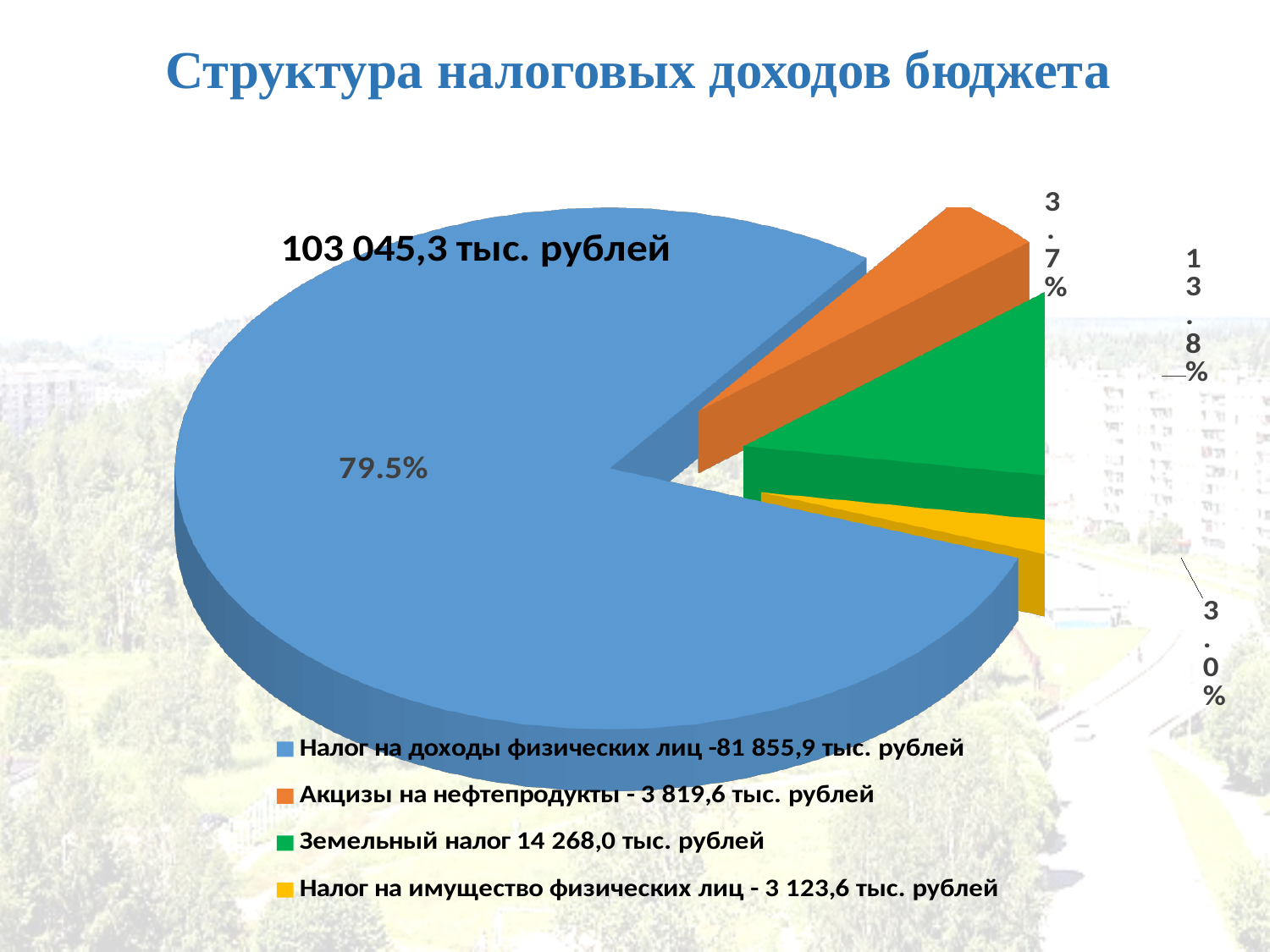
Which category has the largest slice of the pie? Налог на доходы физических лиц What share of the pie is labelled for Налог на доходы физических лиц? 79.5% What share of the pie is labelled for Земельный налог? 13.8% What share of the pie is labelled for Налог на имущество физических лиц? 3.0% Which category has the smallest slice of the pie? Налог на имущество физических лиц What is the difference in percentage points between the share for Налог на доходы физических лиц and the share for Земельный налог? 65.7 How many slices does the pie chart have? 4 Which is larger: the share for Земельный налог or the share for Акцизы на нефтепродукты? Земельный налог How many entries does the legend list? 4 What kind of chart is shown on the slide? Pie chart What total amount is printed on the chart? 103 045,3 тыс. рублей